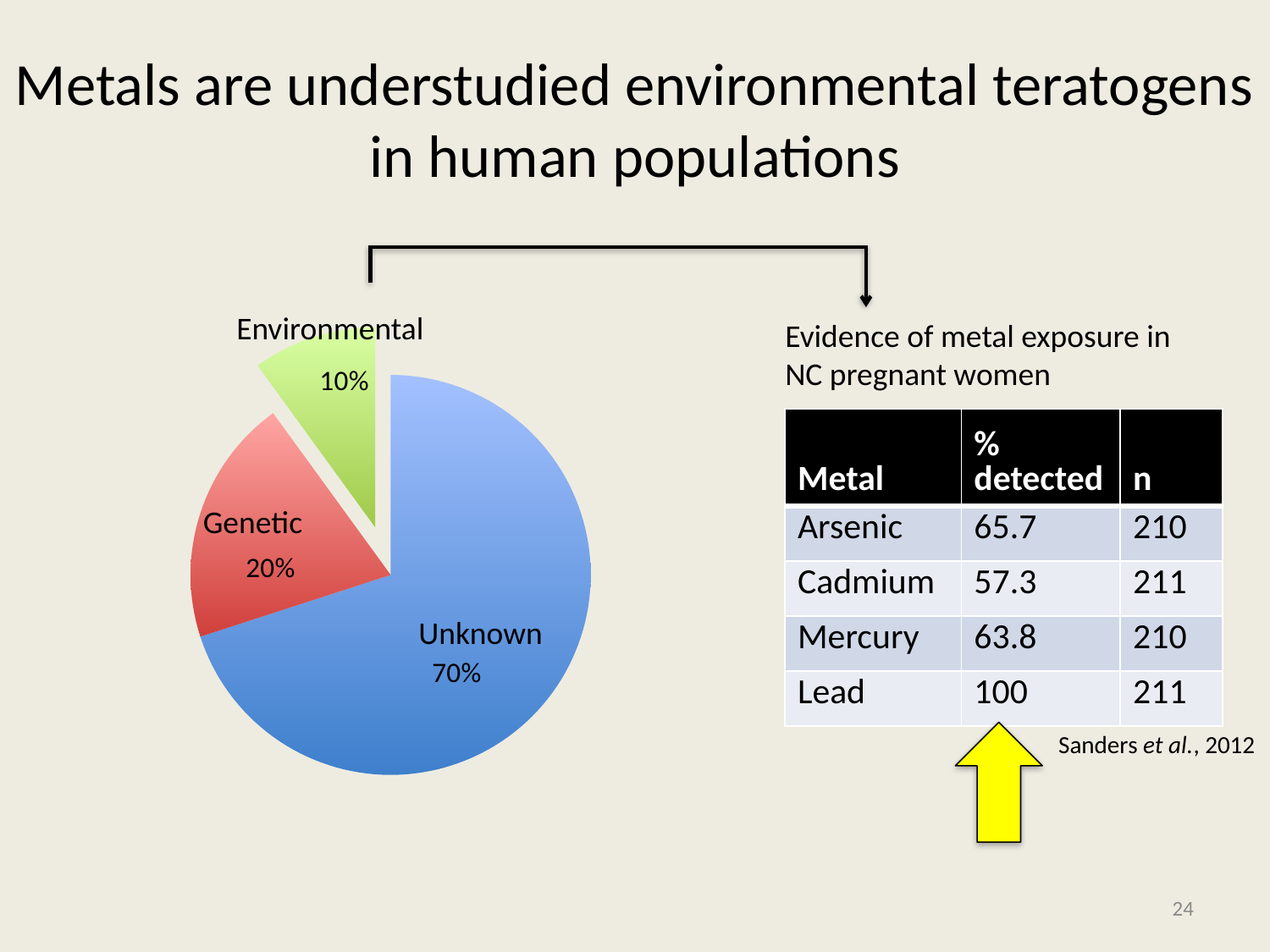
In the pie chart, which is larger: Genetic or Environmental? Genetic What kind of chart is shown on the left of the slide? pie chart What percentage does the pie chart show for Environmental? 10% Which slice of the pie chart is the largest? Unknown Which slice of the pie chart is the smallest? Environmental What percentage does the pie chart show for Genetic? 20% How many slices does the pie chart have? 3 What colour is the Unknown slice in the pie chart? blue In the pie chart, what is the difference between the Unknown and Genetic percentages? 50% Which slice of the pie chart is pulled out (exploded) from the rest? Environmental What percentage does the pie chart show for Unknown? 70% What share of the pie does the Environmental slice represent? 10%